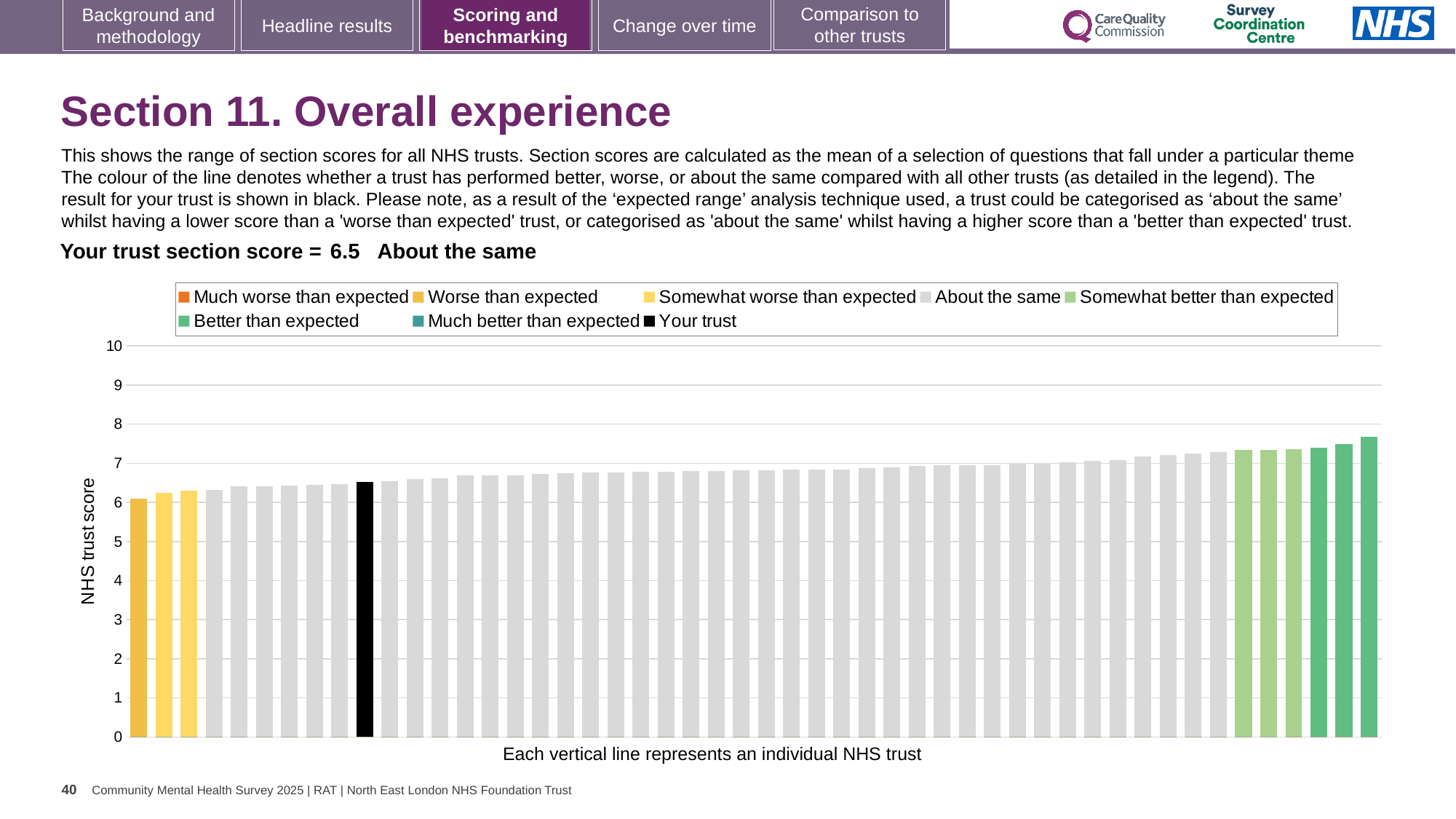
Which colour is used for the 'Your trust' bar? black What is the section score for your trust shown on the chart? 6.5 Is the value of the black 'Your trust' bar greater or less than 6? greater What is the label on the vertical axis of the chart? NHS trust score Is the value of the shortest bar on the chart greater or less than 7? less Which bar is the highest on the chart: the leftmost or the rightmost? rightmost What kind of chart is shown on the slide? bar chart Is the value of the leftmost bar greater or less than 5? greater Do the bar values rise or fall from left to right along the x axis? rise Which category does your trust fall into according to the text above the chart? About the same How many entries does the chart legend list? 8